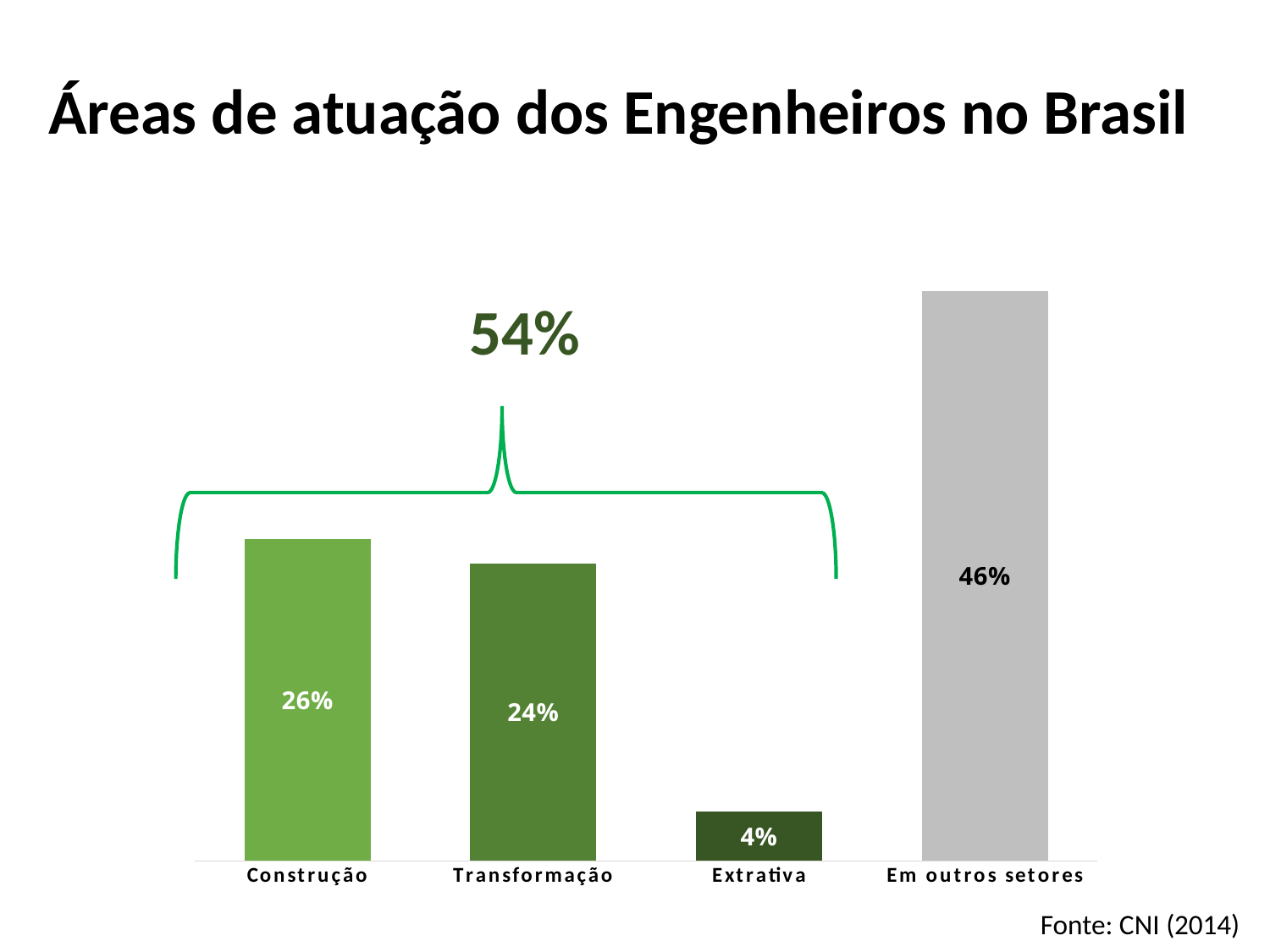
What is the difference between the values for Em outros setores and Construção? 20% How many categories are shown in the chart? 4 What is the difference between the values for Transformação and Extrativa? 20% What kind of chart is shown on the slide? Bar chart What is the value for Extrativa? 4% What is the value for Transformação? 24% What combined percentage does the bracket above the three green bars indicate? 54% What is the value for Construção? 26% Which category has the highest value? Em outros setores Which is larger, the value for Construção or the value for Transformação? Construção What is the value for Em outros setores? 46% Which category has the lowest value? Extrativa